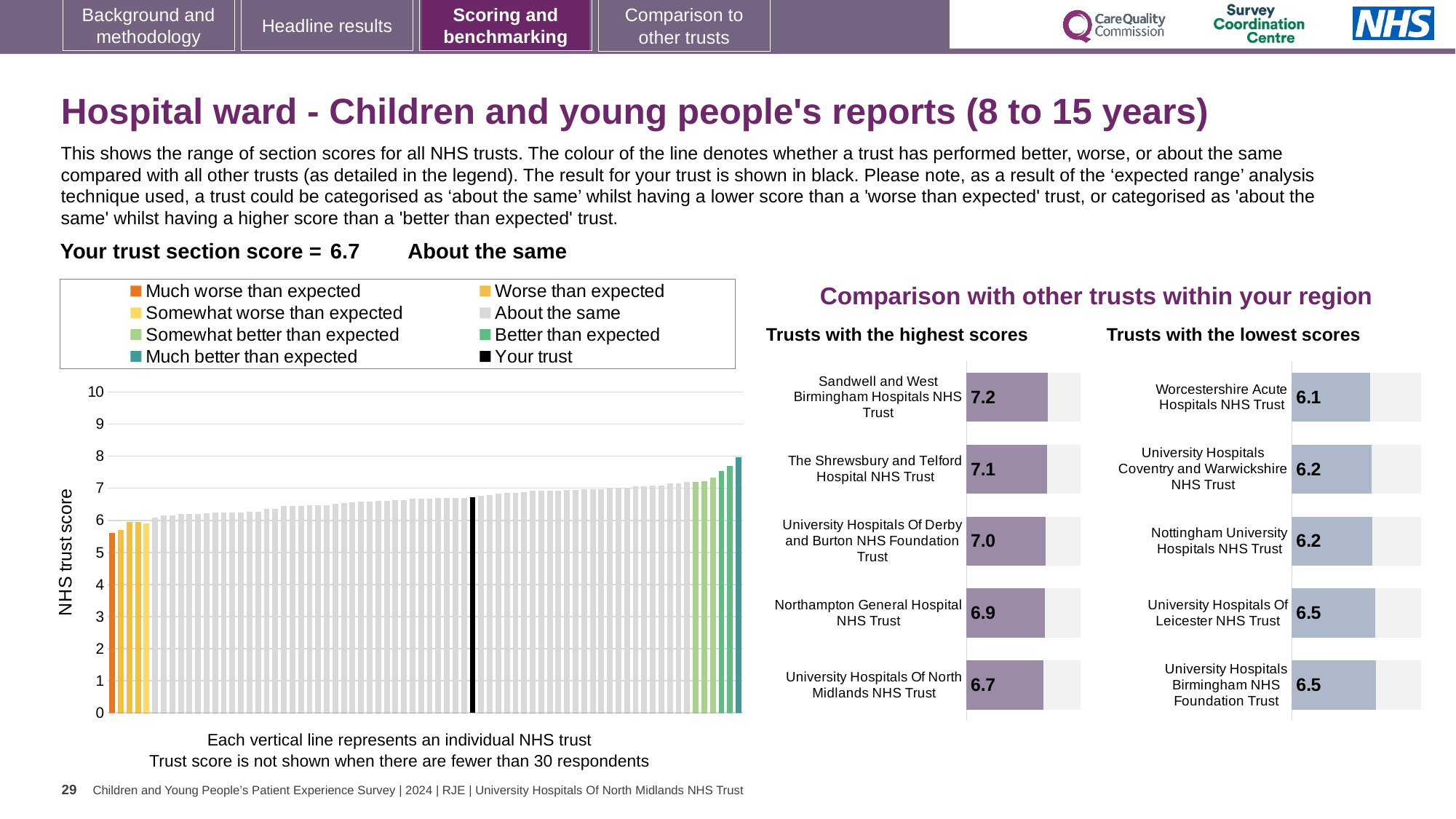
In the 'Trusts with the lowest scores' chart, which trust has the lowest score? Worcestershire Acute Hospitals NHS Trust In the 'Trusts with the highest scores' chart, which has the higher score: The Shrewsbury and Telford Hospital NHS Trust or University Hospitals Of Derby and Burton NHS Foundation Trust? The Shrewsbury and Telford Hospital NHS Trust In the 'Trusts with the highest scores' chart, what is the score for Sandwell and West Birmingham Hospitals NHS Trust? 7.2 How many entries does the legend of the main 'NHS trust score' chart on the left list? 8 In the 'Trusts with the highest scores' chart, which trust has the highest score? Sandwell and West Birmingham Hospitals NHS Trust In the 'Trusts with the highest scores' chart, what is the score for Northampton General Hospital NHS Trust? 6.9 In the main 'NHS trust score' chart on the left, is the value for the black 'Your trust' bar greater or less than 7? less In the main 'NHS trust score' chart on the left, do the bar values rise or fall from left to right? rise How many trusts are shown in the 'Trusts with the lowest scores' chart? 5 In the 'Trusts with the lowest scores' chart, what is the score for Worcestershire Acute Hospitals NHS Trust? 6.1 In the 'Trusts with the highest scores' chart, what is the difference between the scores of Sandwell and West Birmingham Hospitals NHS Trust and University Hospitals Of North Midlands NHS Trust? 0.5 In the 'Trusts with the lowest scores' chart, what is the score for University Hospitals Of Leicester NHS Trust? 6.5